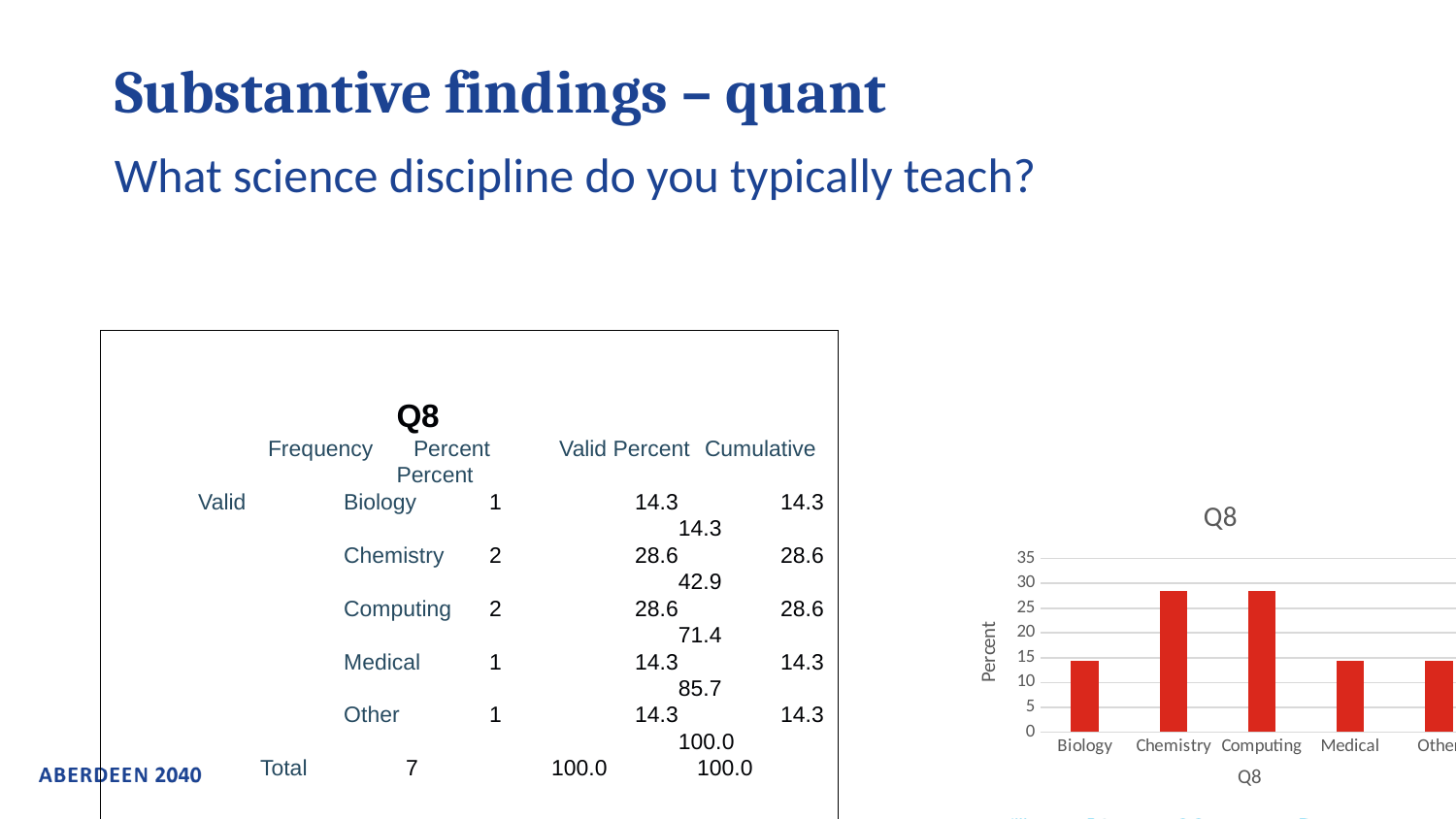
What is the label on the vertical axis of the chart? Percent What is the title of the chart? Q8 Which has the larger value, Chemistry or Biology? Chemistry Is the value for Computing greater or less than 20? greater Which has the larger value, Medical or Computing? Computing Is the value for Other greater or less than 5? greater How many categories are shown on the x axis of the Q8 chart? 5 What kind of chart is shown on the slide? bar chart Is the value for Medical greater or less than 20? less